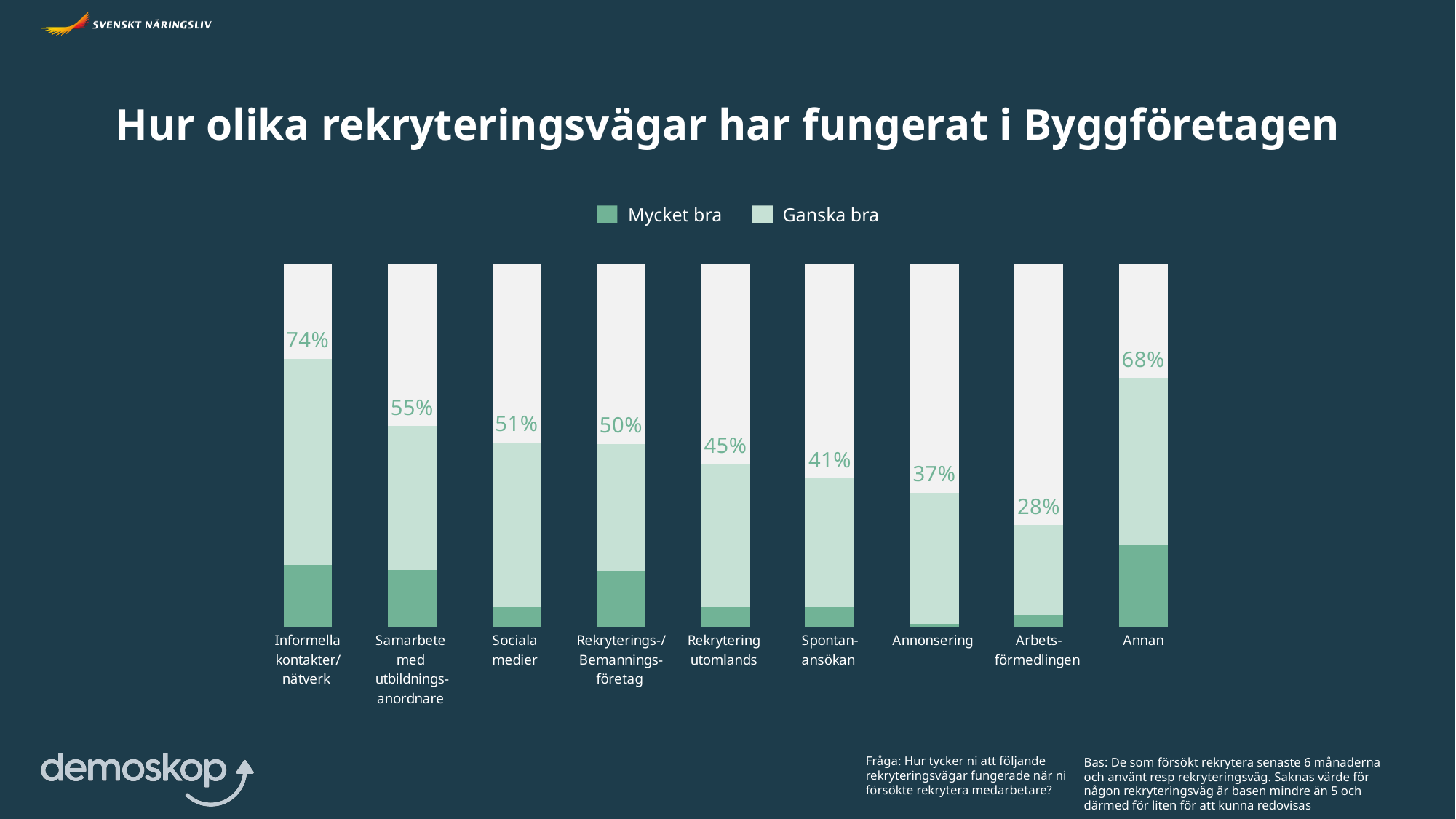
How many recruitment channels (bars) are shown in the chart? 9 Which has a larger labeled total, Samarbete med utbildningsanordnare or Annonsering? Samarbete med utbildningsanordnare What type of chart is shown on the slide? Stacked bar chart What are the two series named in the legend? Mycket bra and Ganska bra What is the labeled total for Annan? 68% What is the labeled total for Informella kontakter/nätverk? 74% What is the difference in percentage points between the labeled totals for Informella kontakter/nätverk and Annan? 6 percentage points How many series does the legend list? 2 What is the labeled total for Spontanansökan? 41% What is the labeled total for Arbetsförmedlingen? 28% Which recruitment channel has the lowest labeled total? Arbetsförmedlingen Which recruitment channel has the highest labeled total? Informella kontakter/nätverk